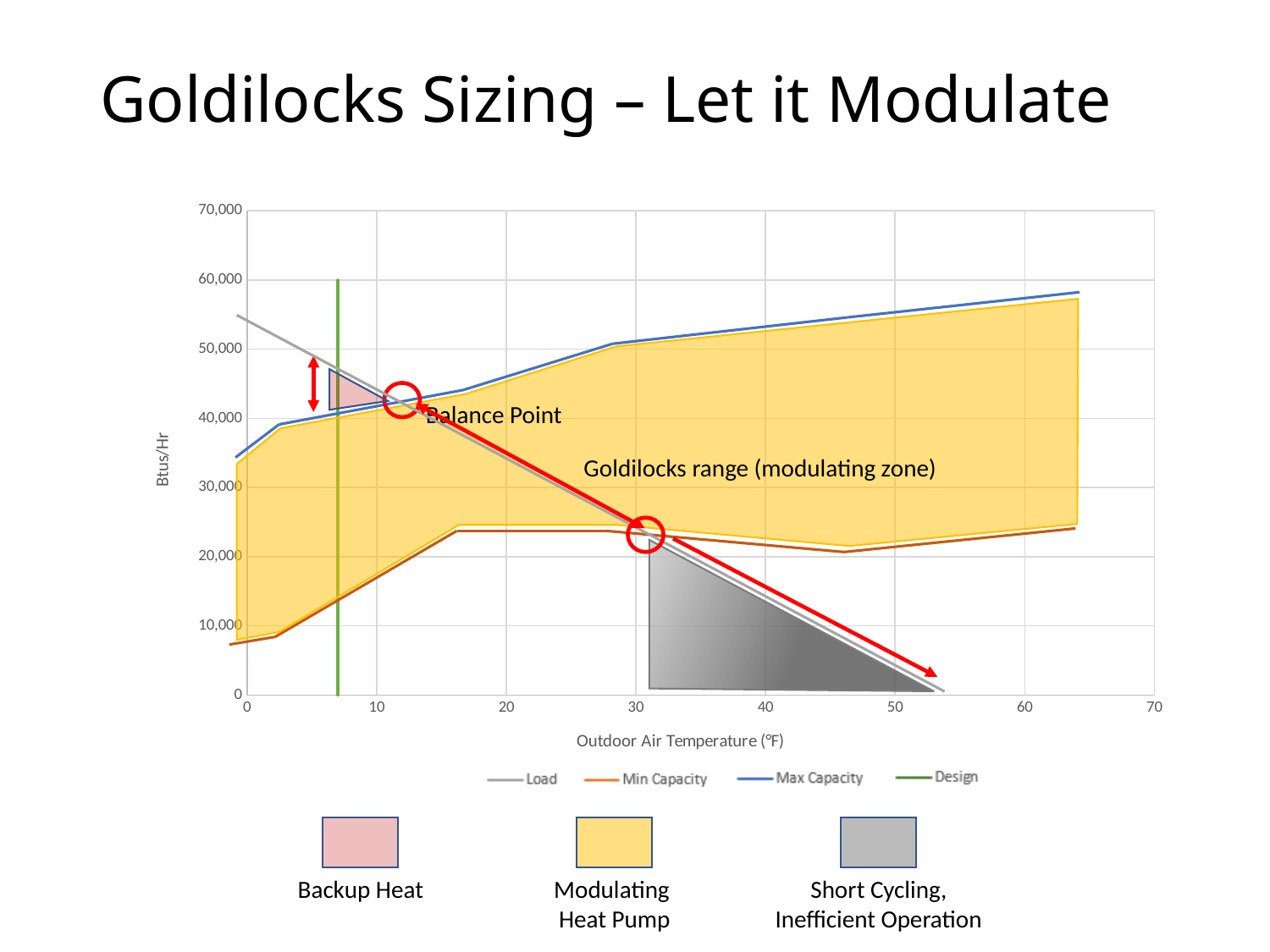
What kind of chart is shown on the slide? line chart At 40°F, which is larger: Max Capacity or Min Capacity? Max Capacity At 0°F, which is larger: Load or Max Capacity? Load Does the Load series rise or fall as outdoor air temperature increases? fall Is the Max Capacity value at 60°F greater or less than 50,000? greater What is the label of the chart's vertical axis? Btus/Hr Does the Max Capacity series generally rise or fall as outdoor air temperature increases? rise Is the Min Capacity value at 40°F greater or less than 30,000? less What is the label of the chart's horizontal axis? Outdoor Air Temperature (°F) How many series does the chart legend list? 4 Is the Load value at 0°F greater or less than 50,000? greater